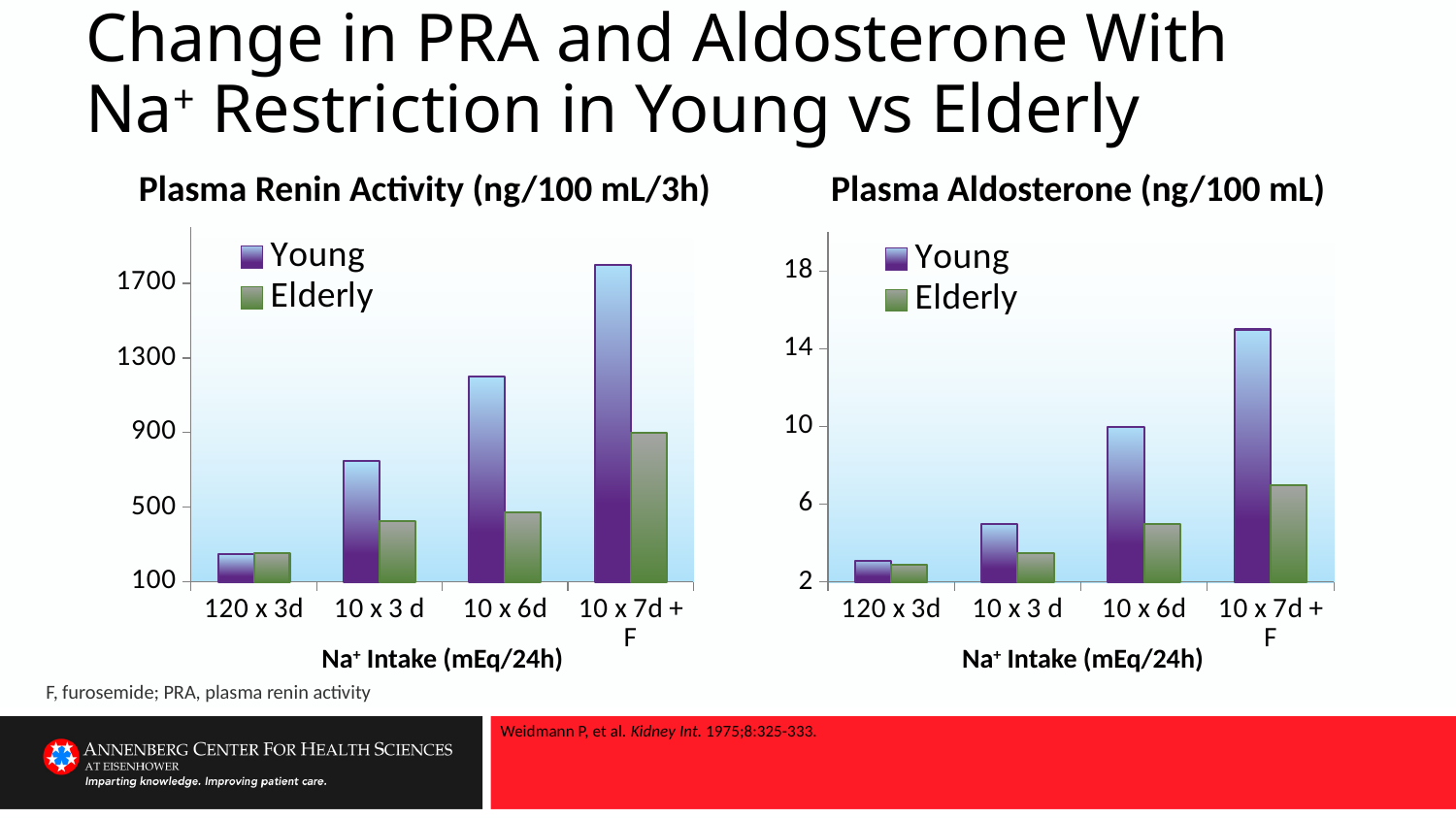
In the Plasma Aldosterone chart, which category has the lowest Elderly value? 120 x 3d In the Plasma Aldosterone chart, do the Young values rise or fall from 120 x 3d to 10 x 7d + F? rise How many series does the legend of the Plasma Aldosterone chart list? 2 In the Plasma Aldosterone chart, which is larger at 10 x 6d, the Young value or the Elderly value? Young In the Plasma Renin Activity chart, is the Young value for 10 x 7d + F greater or less than 1700? greater In the Plasma Renin Activity chart, which category has the highest Young value? 10 x 7d + F How many Na+ intake categories are shown on the x axis of the Plasma Renin Activity chart? 4 What kind of chart is the Plasma Renin Activity chart on the left? bar chart What is the x-axis title of the Plasma Renin Activity chart? Na+ Intake (mEq/24h) In the Plasma Aldosterone chart, is the Young value for 10 x 7d + F greater or less than 14? greater In the Plasma Aldosterone chart, is the Elderly value for 10 x 3 d greater or less than 6? less